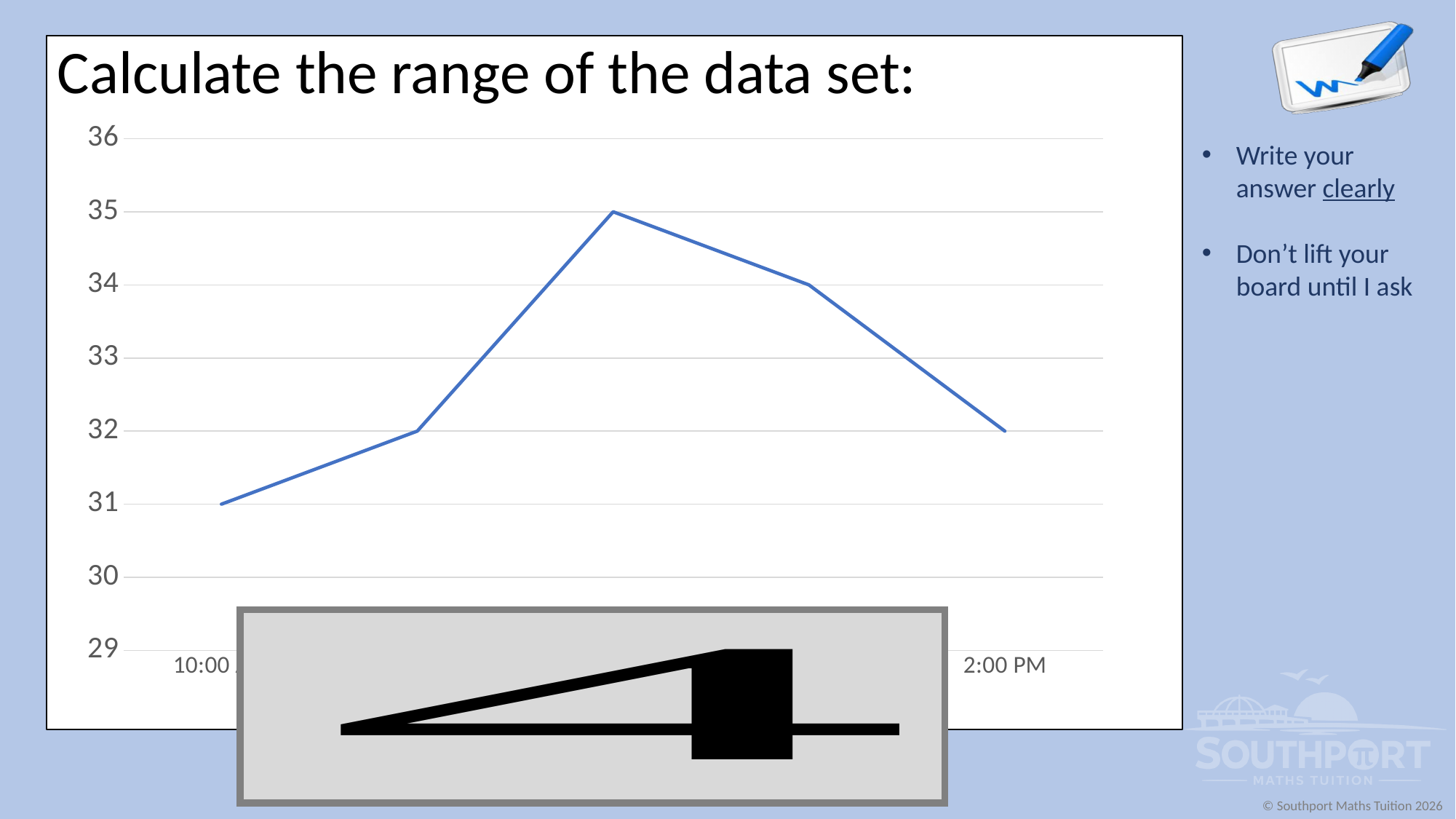
What is the value plotted at 2:00 PM? 32 What is the title of the slide above the chart? Calculate the range of the data set: Which is larger: the first point on the line or the point at 2:00 PM? the point at 2:00 PM What is the highest value plotted on the line? 35 What is the lowest value plotted on the line? 31 How many data points are plotted on the line? 5 Do the values rise or fall from the peak of the line to 2:00 PM? fall What is the value of the first (leftmost) point on the line? 31 What kind of chart is shown on the slide? line chart What colour is the plotted line? blue Is the value at 2:00 PM greater or less than 33? less What is the difference between the highest and lowest plotted values? 4